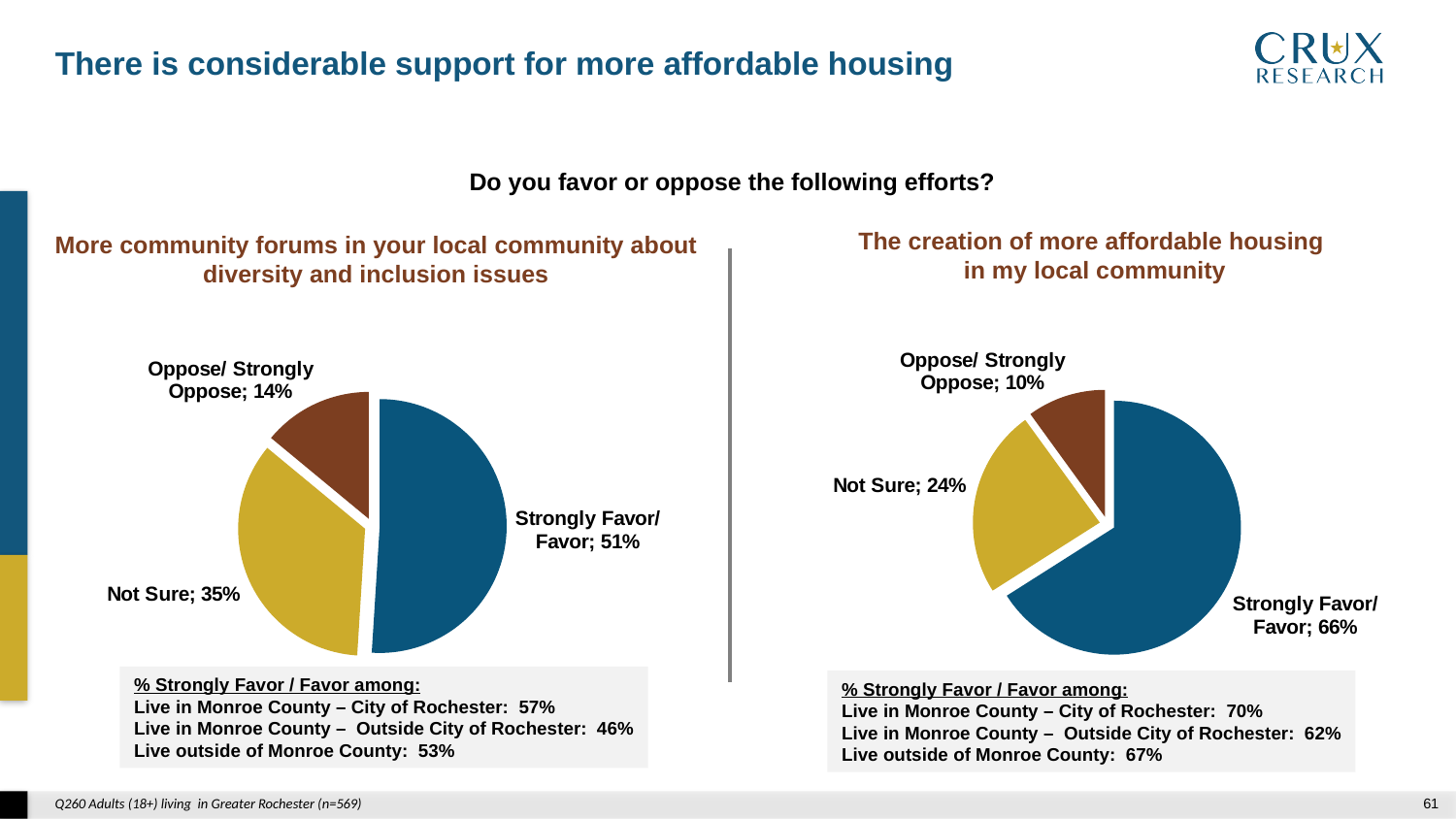
In the 'More community forums' pie chart, what share of respondents answered Oppose/Strongly Oppose? 14% In the 'The creation of more affordable housing' pie chart, what share of respondents answered Not Sure? 24% How many slices does the 'More community forums' pie chart have? 3 In the 'The creation of more affordable housing' pie chart, what share of respondents answered Strongly Favor/Favor? 66% Which chart has the larger Not Sure share: 'More community forums' or 'The creation of more affordable housing'? More community forums In the 'The creation of more affordable housing' pie chart, what share of respondents answered Oppose/Strongly Oppose? 10% What type of chart is used on the right side of the slide for 'The creation of more affordable housing'? Pie chart What is the difference between the Strongly Favor/Favor share in the 'The creation of more affordable housing' chart and the Strongly Favor/Favor share in the 'More community forums' chart? 15 percentage points In the 'More community forums' pie chart, which response has the largest slice? Strongly Favor/Favor In the 'More community forums' pie chart, what share of respondents answered Strongly Favor/Favor? 51% In the 'The creation of more affordable housing' pie chart, which response has the smallest slice? Oppose/Strongly Oppose In the 'More community forums' pie chart, what share of respondents answered Not Sure? 35%